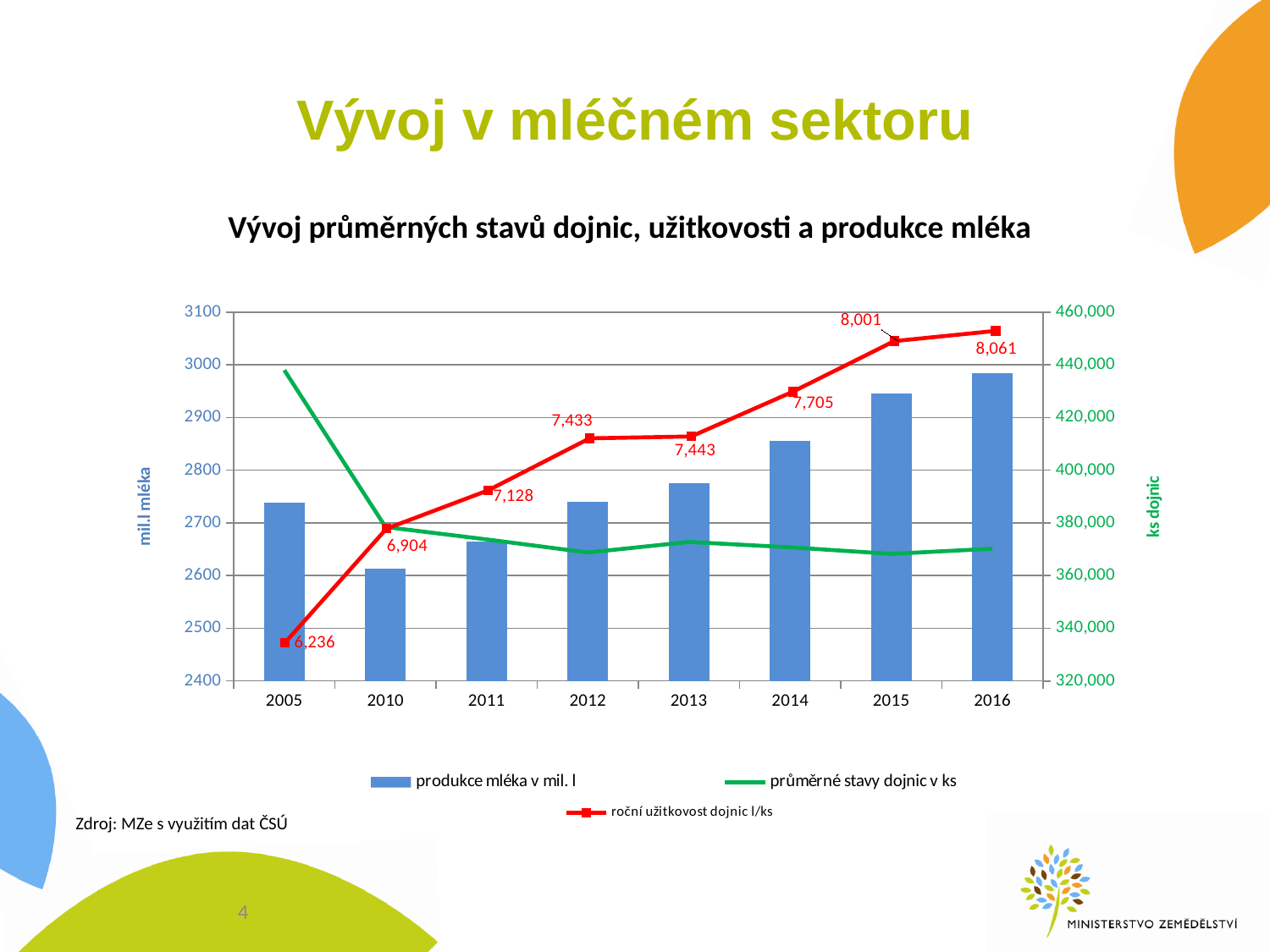
Does the roční užitkovost dojnic l/ks rise or fall from 2005 to 2016? Rises By how much did the roční užitkovost dojnic increase from 2014 to 2015? 296 In which year is the roční užitkovost dojnic l/ks the lowest? 2005 What kind of chart is shown on the slide? Combination bar and line chart How many years are shown on the x axis of the chart? 8 Which year has the higher roční užitkovost dojnic, 2012 or 2013? 2013 Which year has the lowest produkce mléka v mil. l bar? 2010 What is the roční užitkovost dojnic (l/ks) value shown for 2016? 8,061 Is the produkce mléka v mil. l bar for 2010 greater or less than 2700? less How many series does the chart legend list? 3 What is the difference between the roční užitkovost dojnic values for 2016 and 2005? 1,825 What is the roční užitkovost dojnic (l/ks) value shown for 2005? 6,236